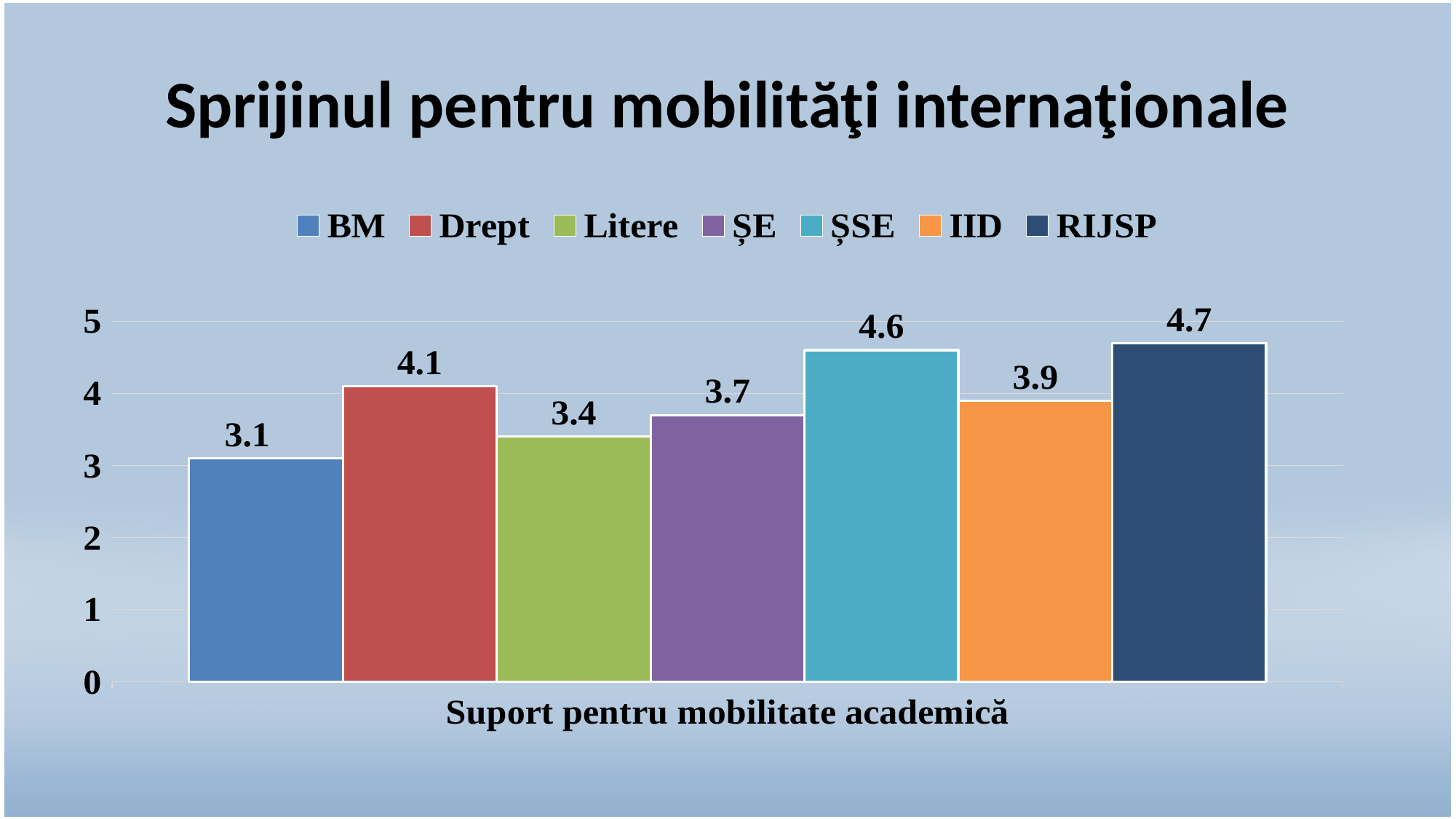
Which series has the lowest value? BM Which is larger, the value for ȘE or the value for Litere? ȘE What is the difference between the values for ȘSE and IID? 0.7 What is the value for Litere? 3.4 What is the value for ȘSE? 4.6 What is the difference between the values for RIJSP and BM? 1.6 Which series has the highest value? RIJSP Is the value for IID greater or less than 4? less What kind of chart is shown on the slide? bar chart How many series does the legend list? 7 What is the title of the chart? Sprijinul pentru mobilităţi internaţionale What is the value for Drept? 4.1